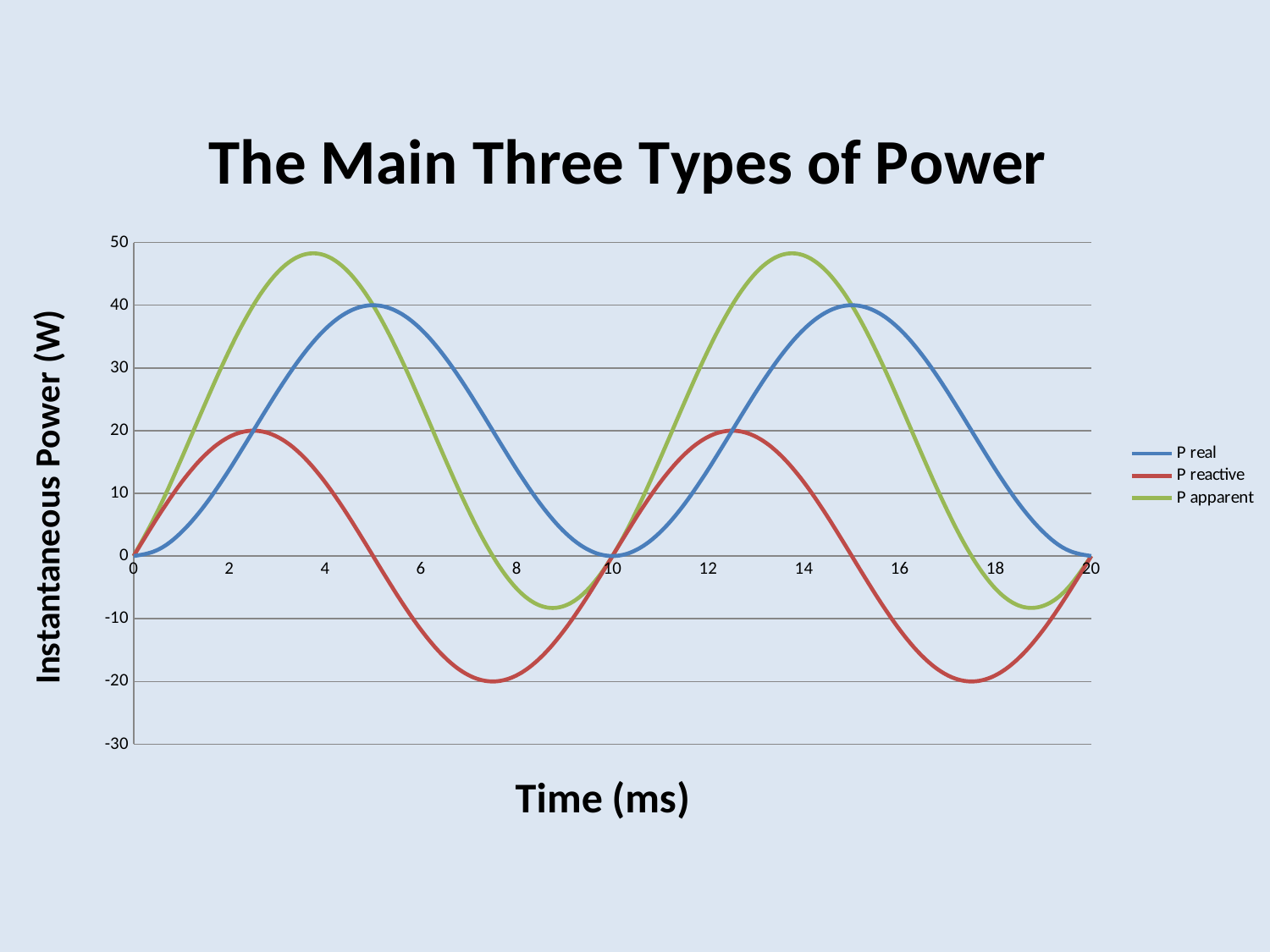
What is the title of the chart? The Main Three Types of Power What kind of chart is shown on the slide? line chart Which series reaches the lowest value on the chart? P reactive What is the minimum value of P reactive? -20 At 8 ms, which is larger, P real or P reactive? P real What is the label of the vertical axis? Instantaneous Power (W) What is the peak value of P real? 40 Is the minimum value of P apparent greater or less than 0? less How many series does the legend list? 3 Which series reaches the highest peak value? P apparent Does P real rise or fall between 5 ms and 10 ms? fall Is the peak value of P apparent greater or less than 40? greater